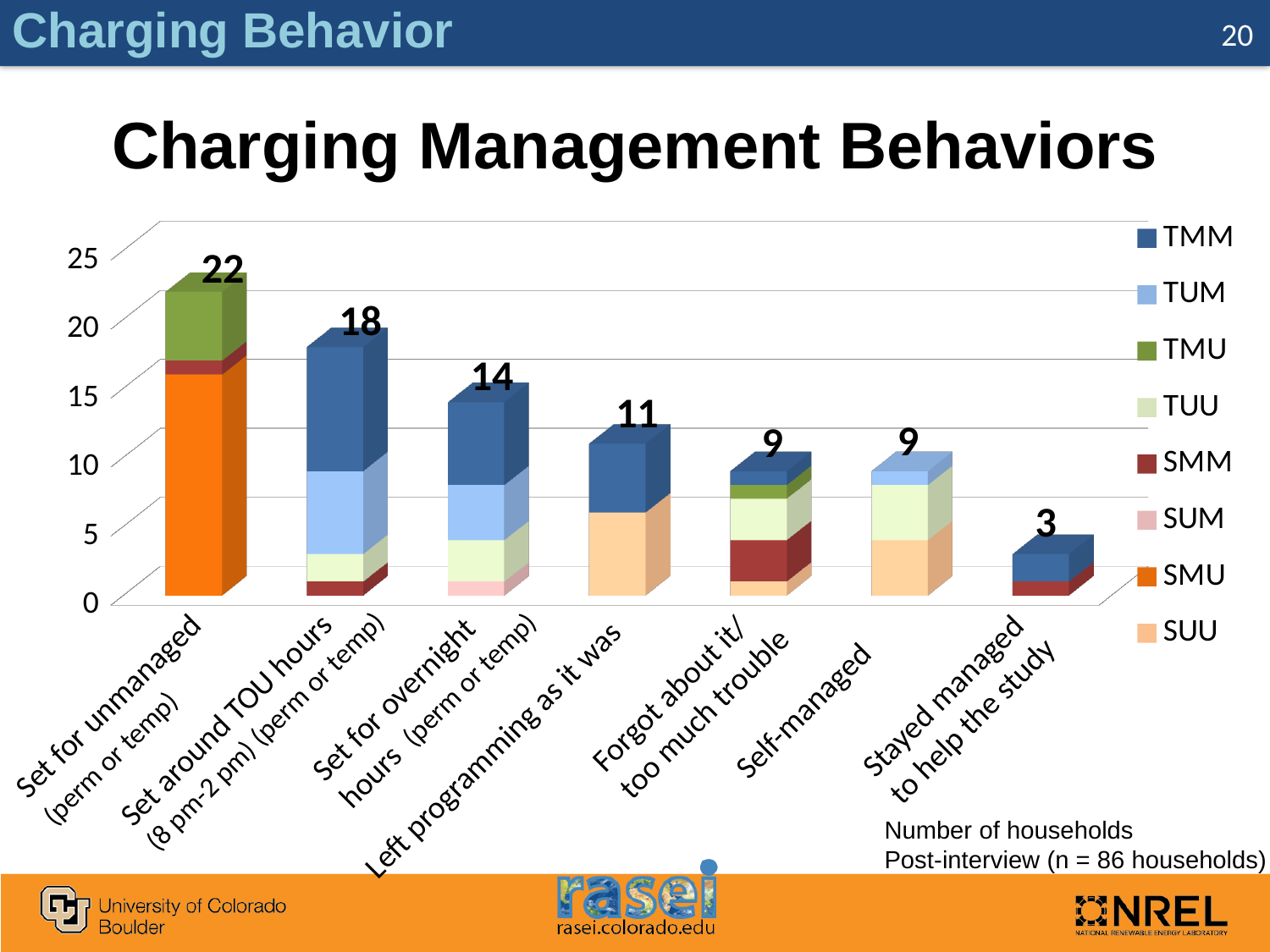
What kind of chart is shown on the slide? Stacked bar chart What is the total number of households for "Left programming as it was"? 11 Which has a larger total, "Set around TOU hours (8 pm-2 pm) (perm or temp)" or "Self-managed"? Set around TOU hours (8 pm-2 pm) (perm or temp) How many categories are shown on the x axis? 7 What is the difference between the totals for "Set for unmanaged (perm or temp)" and "Set for overnight hours (perm or temp)"? 8 How many series does the legend list? 8 What is the total number of households for "Set for unmanaged (perm or temp)"? 22 Do the bar totals rise or fall from left to right along the x axis? Fall Which category has the highest total number of households? Set for unmanaged (perm or temp) What is the total number of households for "Set around TOU hours (8 pm-2 pm) (perm or temp)"? 18 Is the total for "Set for overnight hours (perm or temp)" greater or less than 10? greater Which category has the lowest total number of households? Stayed managed to help the study